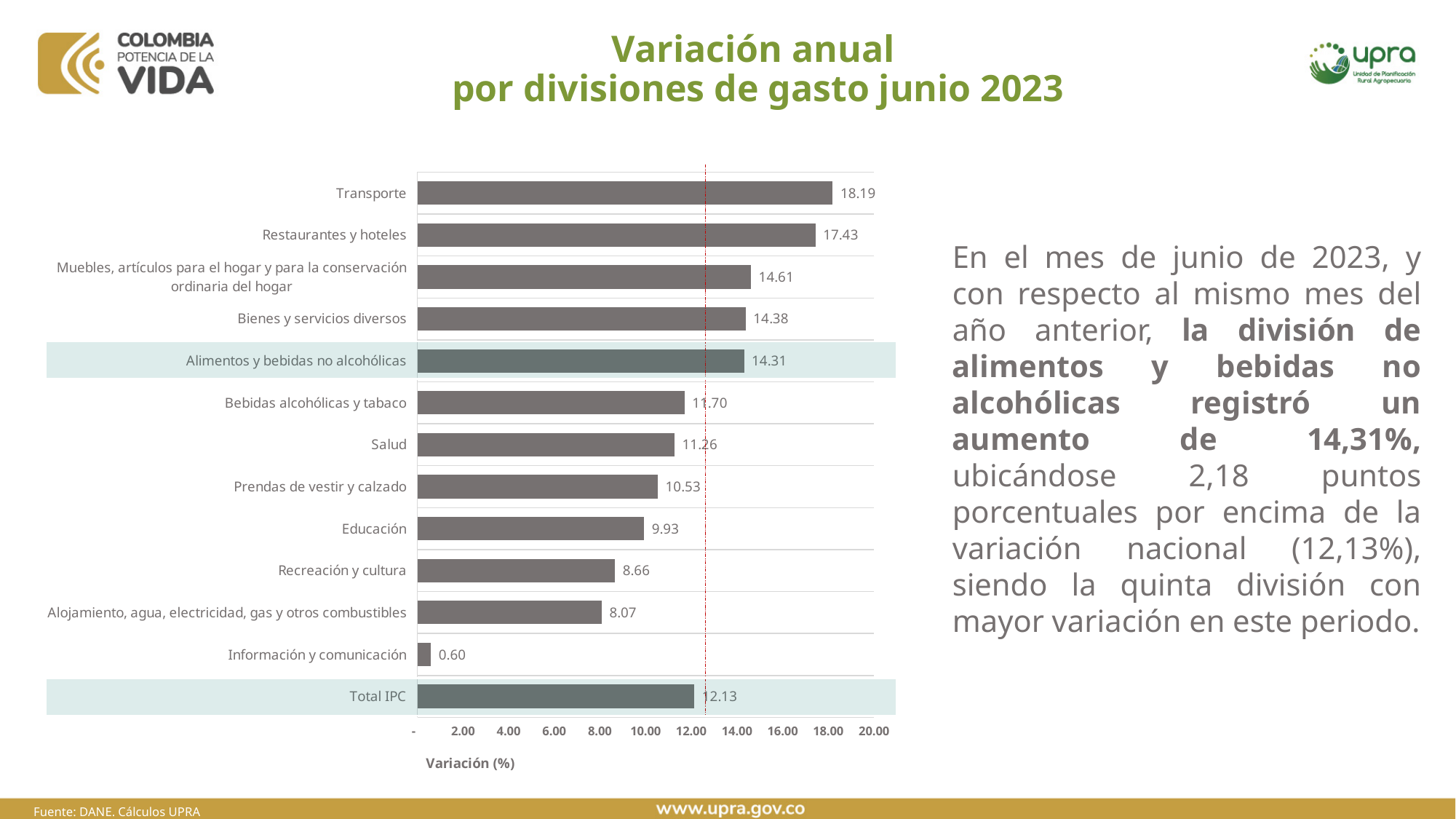
What is the value for Transporte? 18.19 What is the value for Información y comunicación? 0.60 What is the label of the horizontal axis? Variación (%) Which category has the highest value? Transporte Which is larger, the value for Salud or the value for Educación? Salud Is the value for Recreación y cultura greater or less than 10.00? less Which category has the lowest value? Información y comunicación What is the difference between the values for Alimentos y bebidas no alcohólicas and Total IPC? 2.18 What is the value for Total IPC? 12.13 What is the value for Alimentos y bebidas no alcohólicas? 14.31 How many categories are shown in the chart? 13 What kind of chart is shown on the slide? bar chart